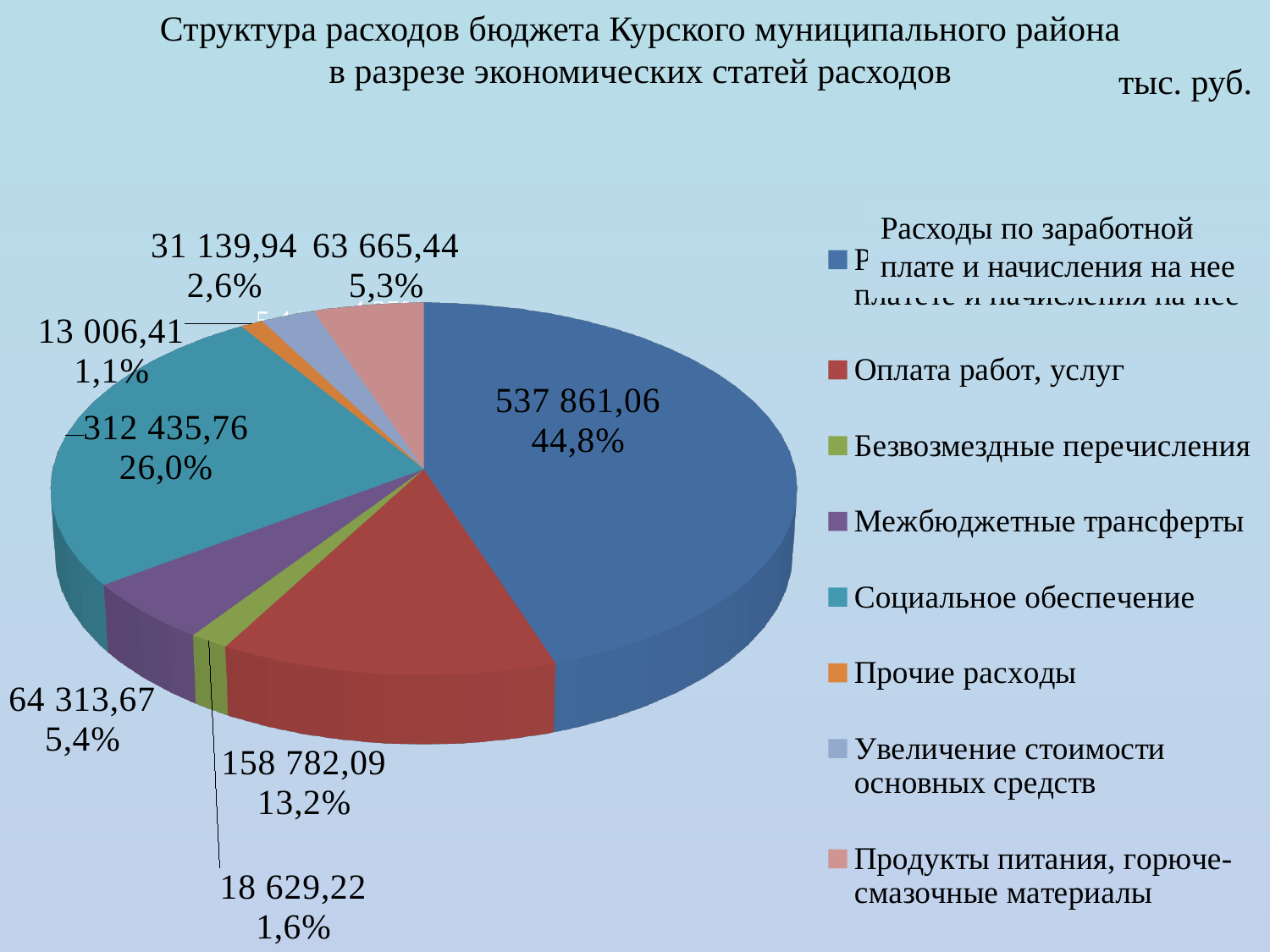
What unit is indicated in the top right corner of the slide? тыс. руб. What is the value for Расходы по заработной плате и начисления на нее? 537 861,06 Which category has the largest slice of the pie? Расходы по заработной плате и начисления на нее Which is larger: Межбюджетные трансферты or Увеличение стоимости основных средств? Межбюджетные трансферты What is the value for Продукты питания, горюче-смазочные материалы? 63 665,44 What is the value for Оплата работ, услуг? 158 782,09 How many categories does the legend of the pie chart list? 8 What is the difference between the values for Расходы по заработной плате и начисления на нее and Социальное обеспечение? 225 425,30 What kind of chart is shown on the slide? pie chart What share of the pie does Безвозмездные перечисления take? 1,6% Which category has the smallest slice of the pie? Прочие расходы What share of the pie does Социальное обеспечение take? 26,0%